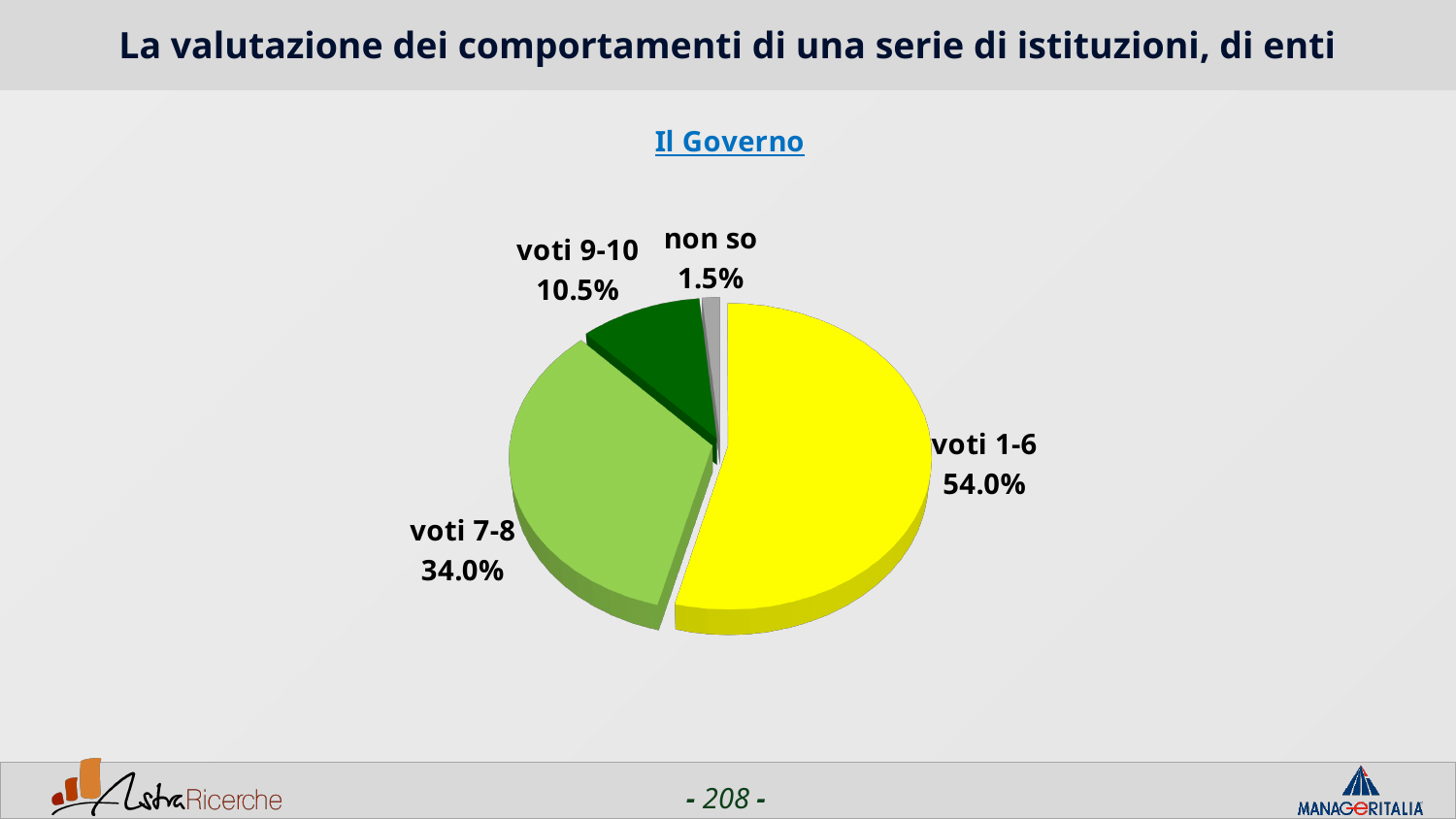
What is the difference between the values for 'voti 1-6' and 'voti 7-8'? 20.0% What is the title of the pie chart? Il Governo What is the value for 'voti 9-10'? 10.5% What kind of chart is shown on the slide? pie chart Which category has the smallest share of the pie? non so What is the value for 'voti 7-8'? 34.0% Which category has the largest share of the pie? voti 1-6 What colour is the slice for 'voti 1-6'? yellow Which is larger, the value for 'voti 9-10' or the value for 'non so'? voti 9-10 What is the value for 'non so'? 1.5% What is the value for 'voti 1-6'? 54.0% How many slices does the pie chart have? 4